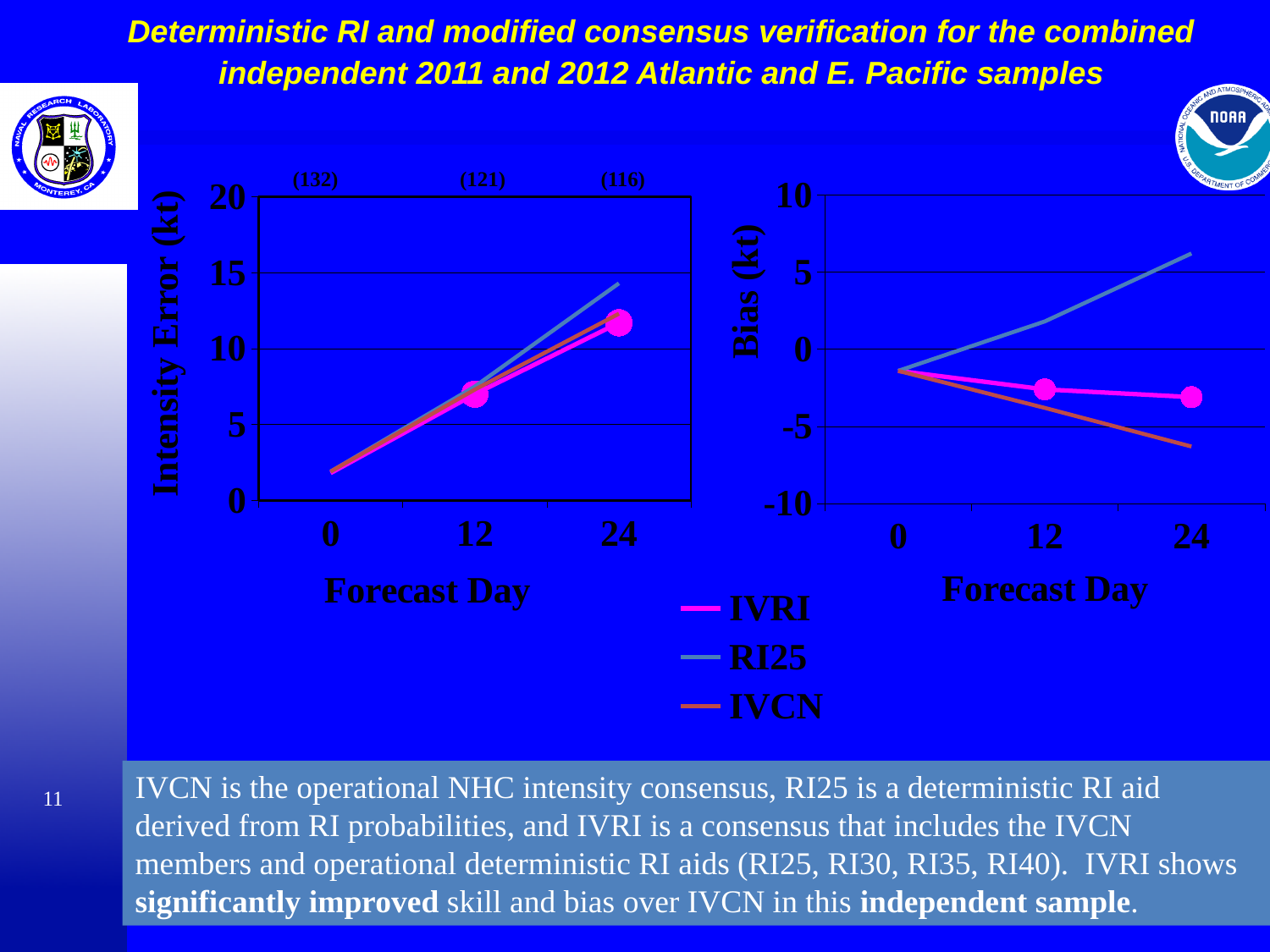
In the left chart (Intensity Error), which series has the highest intensity error at forecast day 24? RI25 In the left chart (Intensity Error), how many forecast days are plotted along the x axis? 3 In the left chart (Intensity Error), is the value for IVRI at forecast day 0 greater or less than 5? less In the right chart (Bias), does the bias for RI25 rise or fall from forecast day 0 to day 24? rise What is the y-axis title of the right chart? Bias (kt) What type of chart is the left chart (Intensity Error)? line chart In the right chart (Bias), is the value for IVCN at forecast day 24 greater or less than -5? less In the left chart (Intensity Error), is the value for RI25 at forecast day 24 greater or less than 10? greater How many series does the legend list? 3 In the left chart (Intensity Error), does the intensity error for IVCN rise or fall from forecast day 0 to day 24? rise In the right chart (Bias), which series has the lowest bias at forecast day 24? IVCN